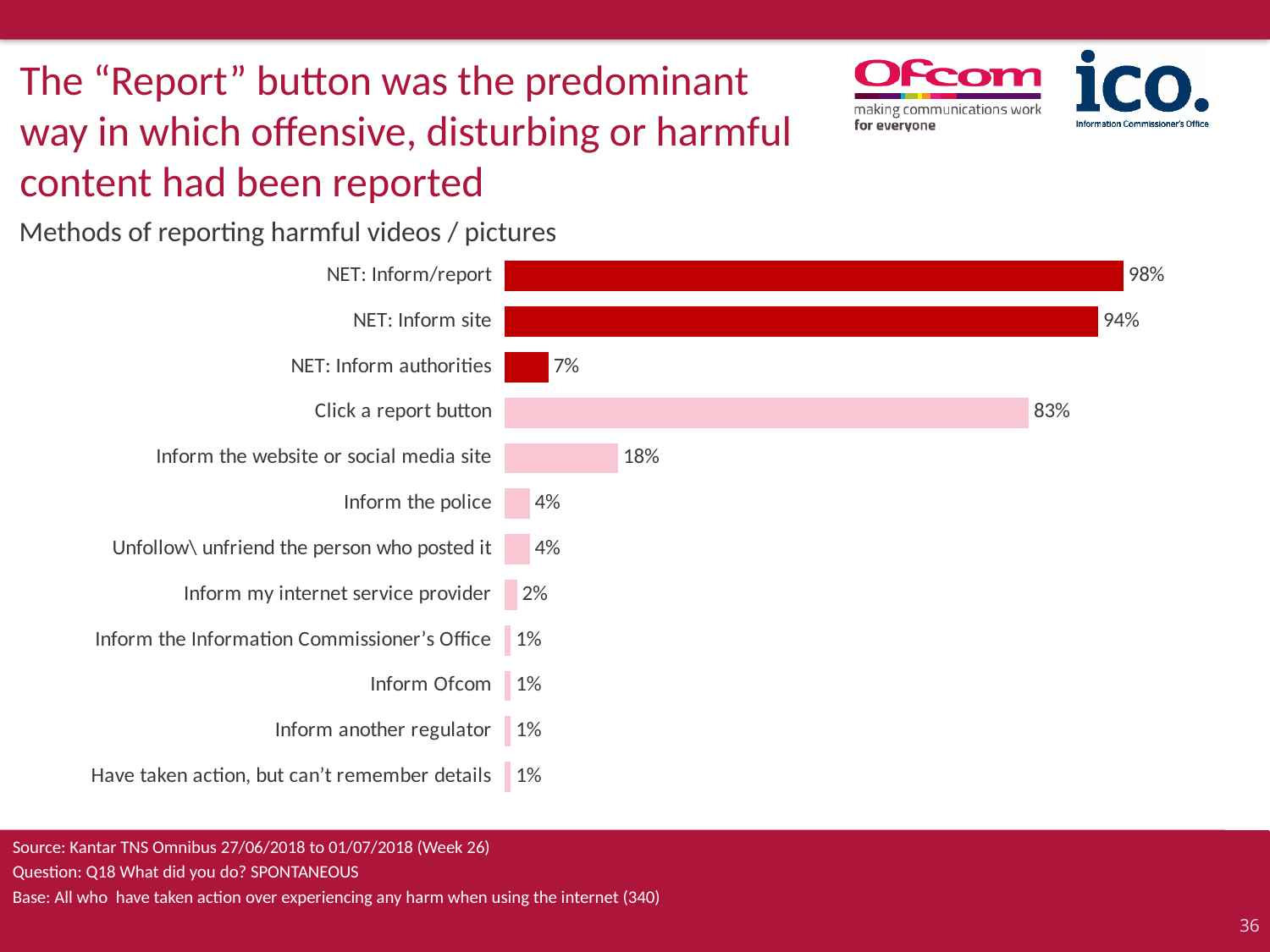
What kind of chart is shown on the slide? Bar chart What is the difference between "Click a report button" and "Inform the website or social media site"? 65% Which is larger, "Inform the police" or "Inform my internet service provider"? Inform the police What is the value for "NET: Inform authorities"? 7% How many categories are shown in the chart? 12 What is the value for "Inform Ofcom"? 1% Which category has the highest value? NET: Inform/report What is the value for "Inform the website or social media site"? 18% What is the difference between "NET: Inform/report" and "NET: Inform site"? 4% What is the subtitle of the chart? Methods of reporting harmful videos / pictures What is the value for "Inform the police"? 4% What is the value for "Click a report button"? 83%